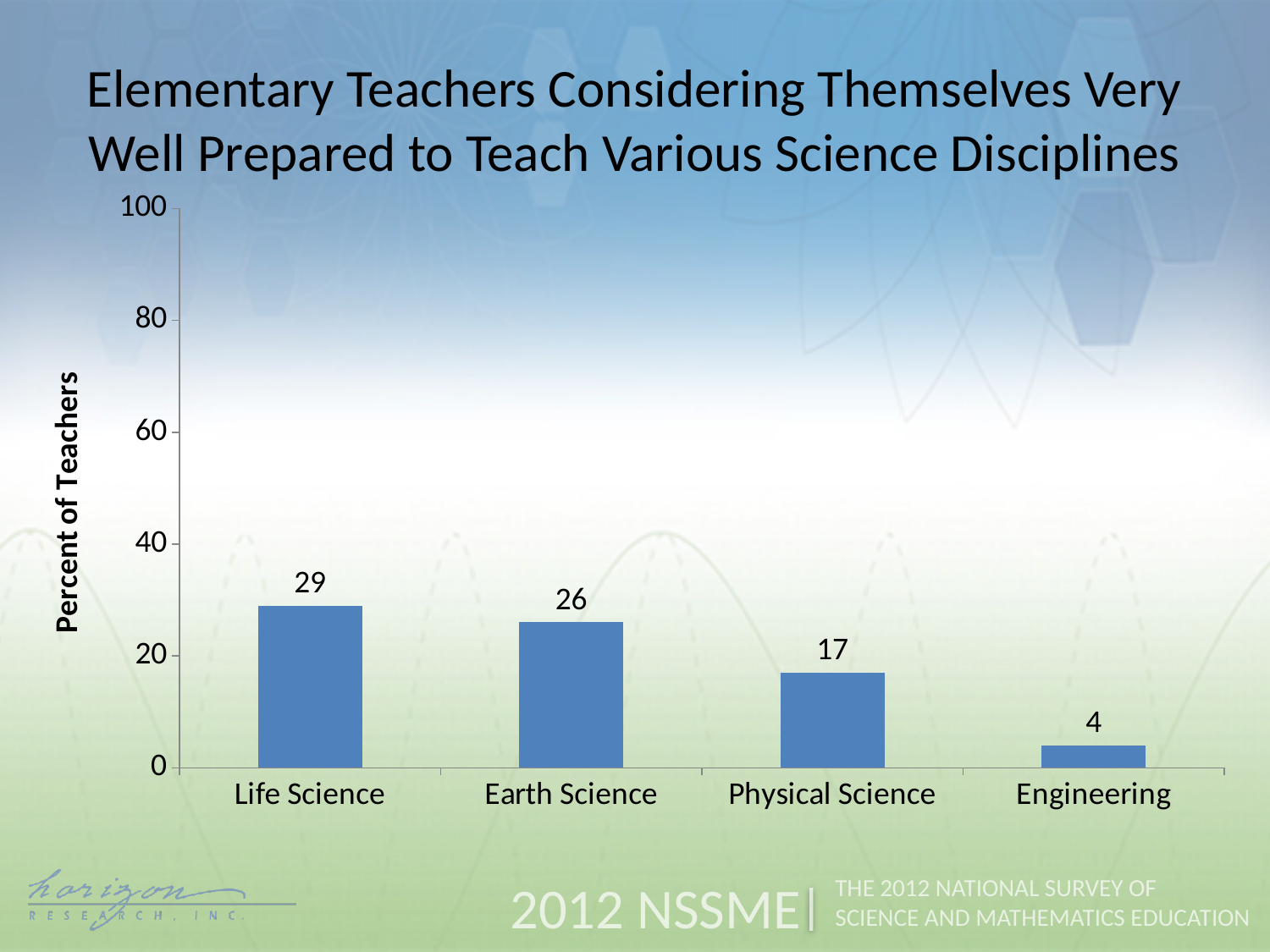
What kind of chart is shown on the slide? Bar chart What is the difference between the values for Life Science and Engineering? 25 What is the value shown for Earth Science? 26 How many science disciplines are shown on the x axis? 4 What is the value shown for Engineering? 4 Which science discipline has the highest percent of teachers considering themselves very well prepared? Life Science Which discipline has the lowest percent of teachers? Engineering Which is larger, the value for Earth Science or the value for Physical Science? Earth Science Is the value for Physical Science greater or less than 20? less What percent of elementary teachers consider themselves very well prepared to teach Life Science? 29 What is the value shown for Physical Science? 17 What is the difference between the values for Earth Science and Physical Science? 9